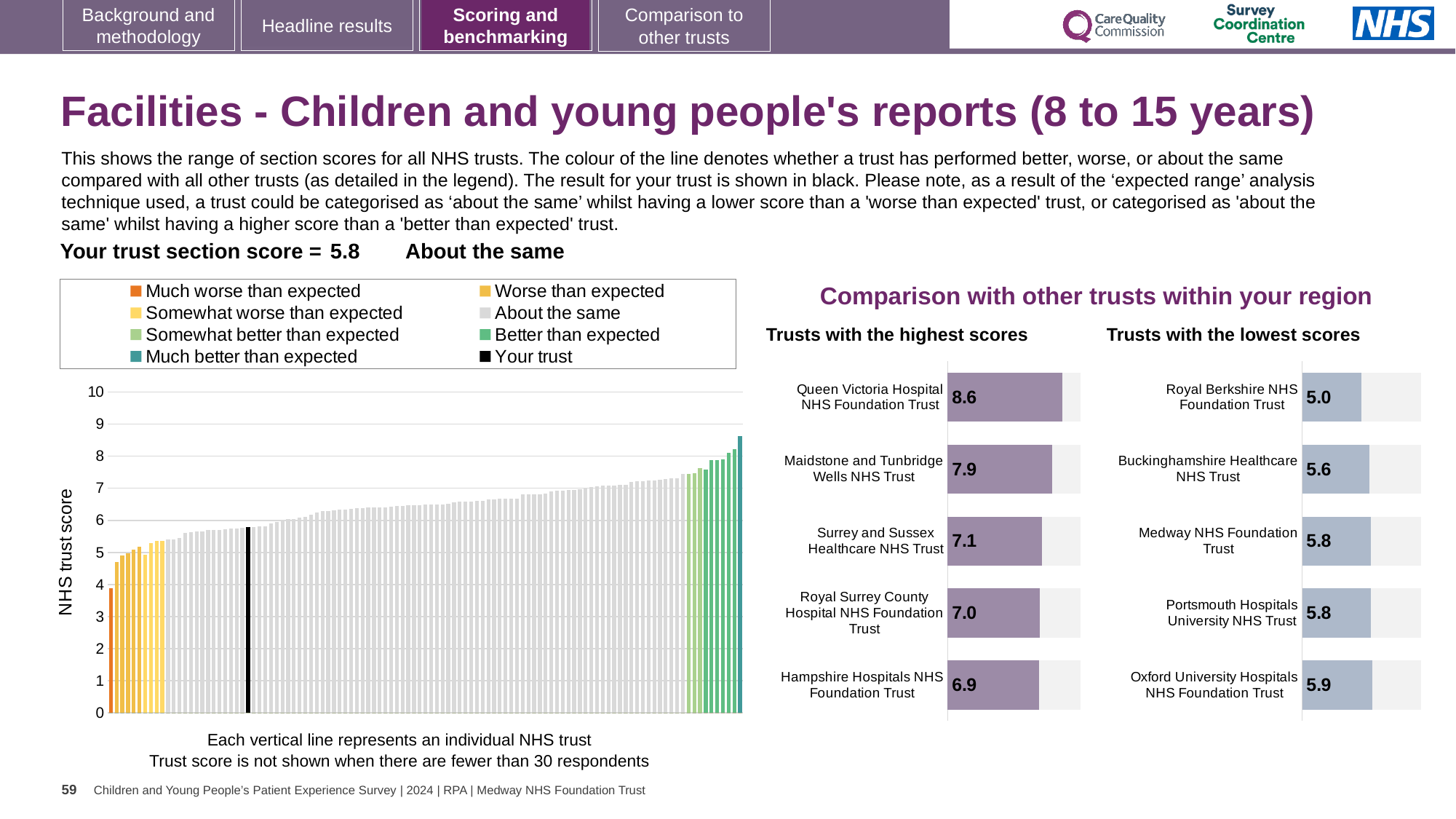
What kind of chart is the large chart on the left showing NHS trust scores? Bar chart How many trusts are shown in the 'Trusts with the lowest scores' chart? 5 In the 'Trusts with the lowest scores' chart, what is the score for Portsmouth Hospitals University NHS Trust? 5.8 In the 'Trusts with the highest scores' chart, what is the score for Queen Victoria Hospital NHS Foundation Trust? 8.6 In the 'Trusts with the lowest scores' chart, what is the score for Royal Berkshire NHS Foundation Trust? 5.0 How many entries does the legend of the large chart on the left list? 8 In the 'Trusts with the lowest scores' chart, which trust has the highest score? Oxford University Hospitals NHS Foundation Trust In the 'Trusts with the lowest scores' chart, which has the larger score: Buckinghamshire Healthcare NHS Trust or Medway NHS Foundation Trust? Medway NHS Foundation Trust In the large chart on the left, do the trust scores rise or fall from left to right? Rise In the large chart on the left, is the value of the black bar (your trust) greater or less than 6? less In the 'Trusts with the highest scores' chart, which trust has the lowest score? Hampshire Hospitals NHS Foundation Trust In the 'Trusts with the highest scores' chart, what is the difference between the scores of Queen Victoria Hospital NHS Foundation Trust and Maidstone and Tunbridge Wells NHS Trust? 0.7